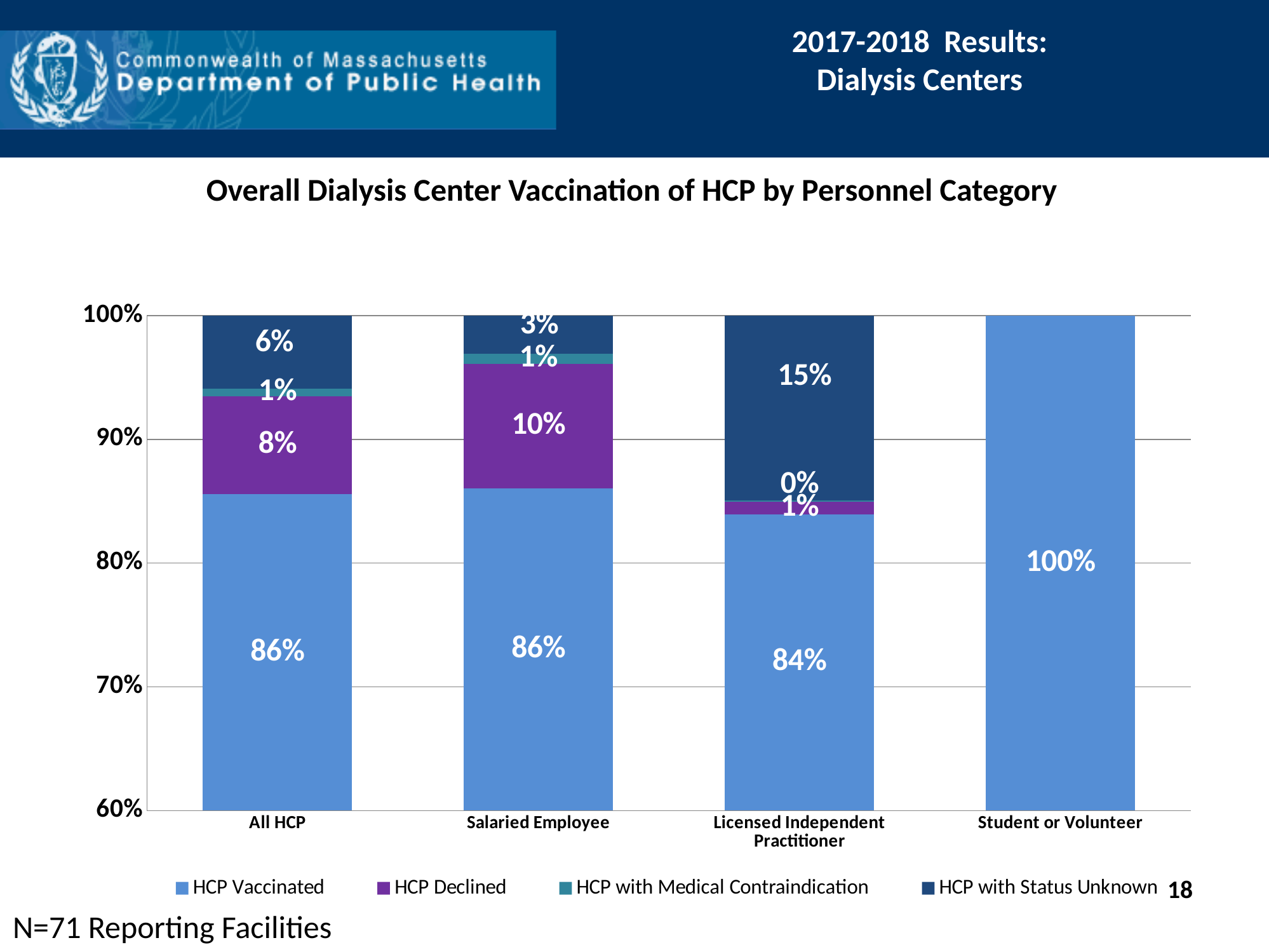
Which personnel category has the highest HCP with Status Unknown value? Licensed Independent Practitioner What is the title of the chart? Overall Dialysis Center Vaccination of HCP by Personnel Category How many personnel categories are shown on the x axis? 4 What percentage of HCP were vaccinated in the Salaried Employee category? 86% What is the difference between the HCP Declined values for Salaried Employee and All HCP? 2% What is the HCP Vaccinated value for Student or Volunteer? 100% What is the HCP with Status Unknown value for All HCP? 6% What is the HCP Declined value for the Licensed Independent Practitioner category? 1% What kind of chart is shown on the slide? Stacked bar chart Which is larger: the HCP with Status Unknown value for Salaried Employee or for All HCP? All HCP How many series does the legend list? 4 Which personnel category has the lowest HCP Vaccinated value? Licensed Independent Practitioner